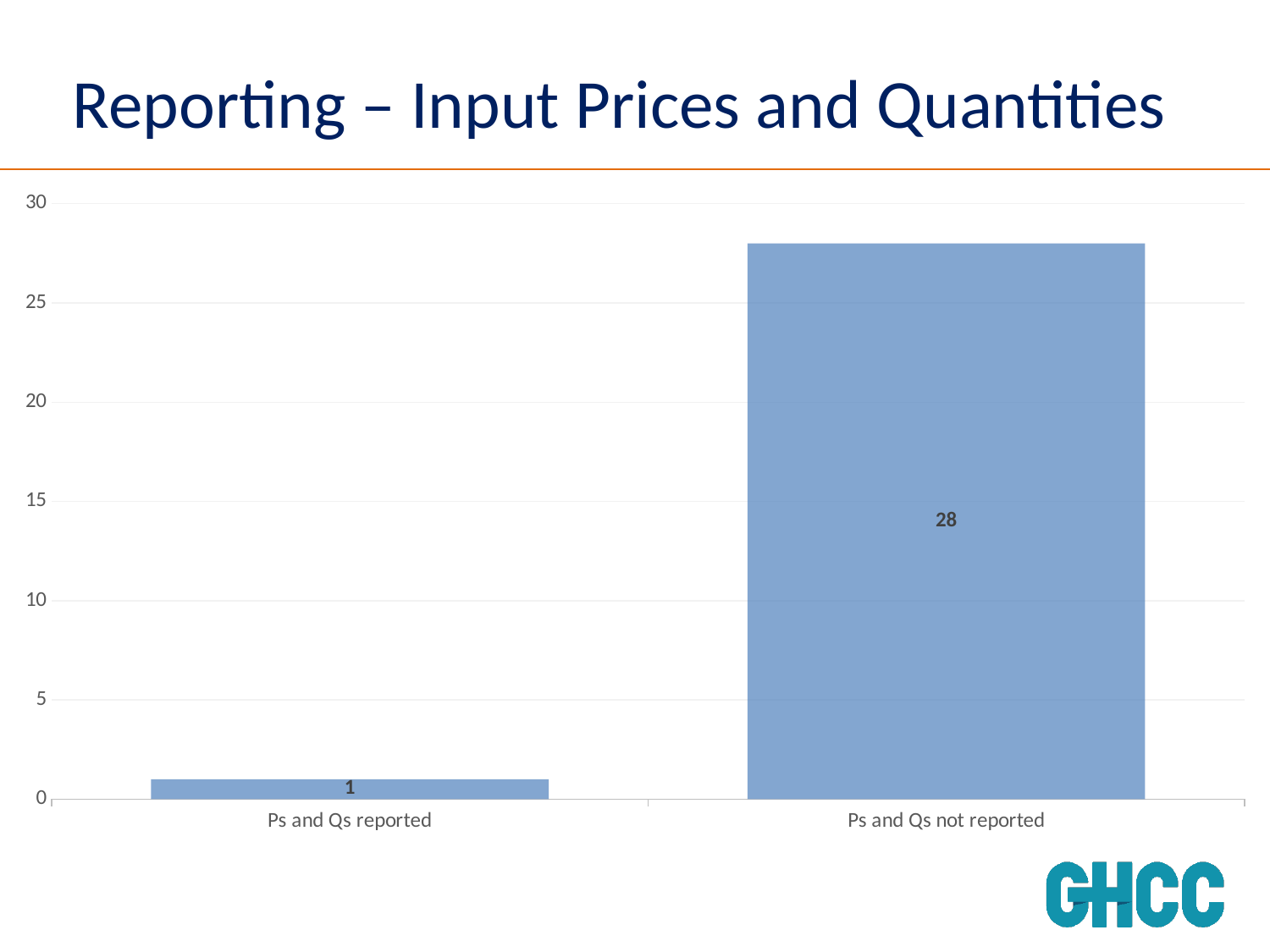
How many categories are shown on the x axis? 2 What is the value for "Ps and Qs reported"? 1 Which category has the lowest value? Ps and Qs reported What is the value for "Ps and Qs not reported"? 28 Is the value for "Ps and Qs not reported" greater or less than 25? greater Which category has the highest value? Ps and Qs not reported What is the title of the slide containing the chart? Reporting – Input Prices and Quantities Which is larger, the value for "Ps and Qs reported" or the value for "Ps and Qs not reported"? Ps and Qs not reported Is the value for "Ps and Qs reported" greater or less than 5? less What is the total of the two bars combined? 29 What is the difference between the values for "Ps and Qs not reported" and "Ps and Qs reported"? 27 What kind of chart is shown on the slide? bar chart